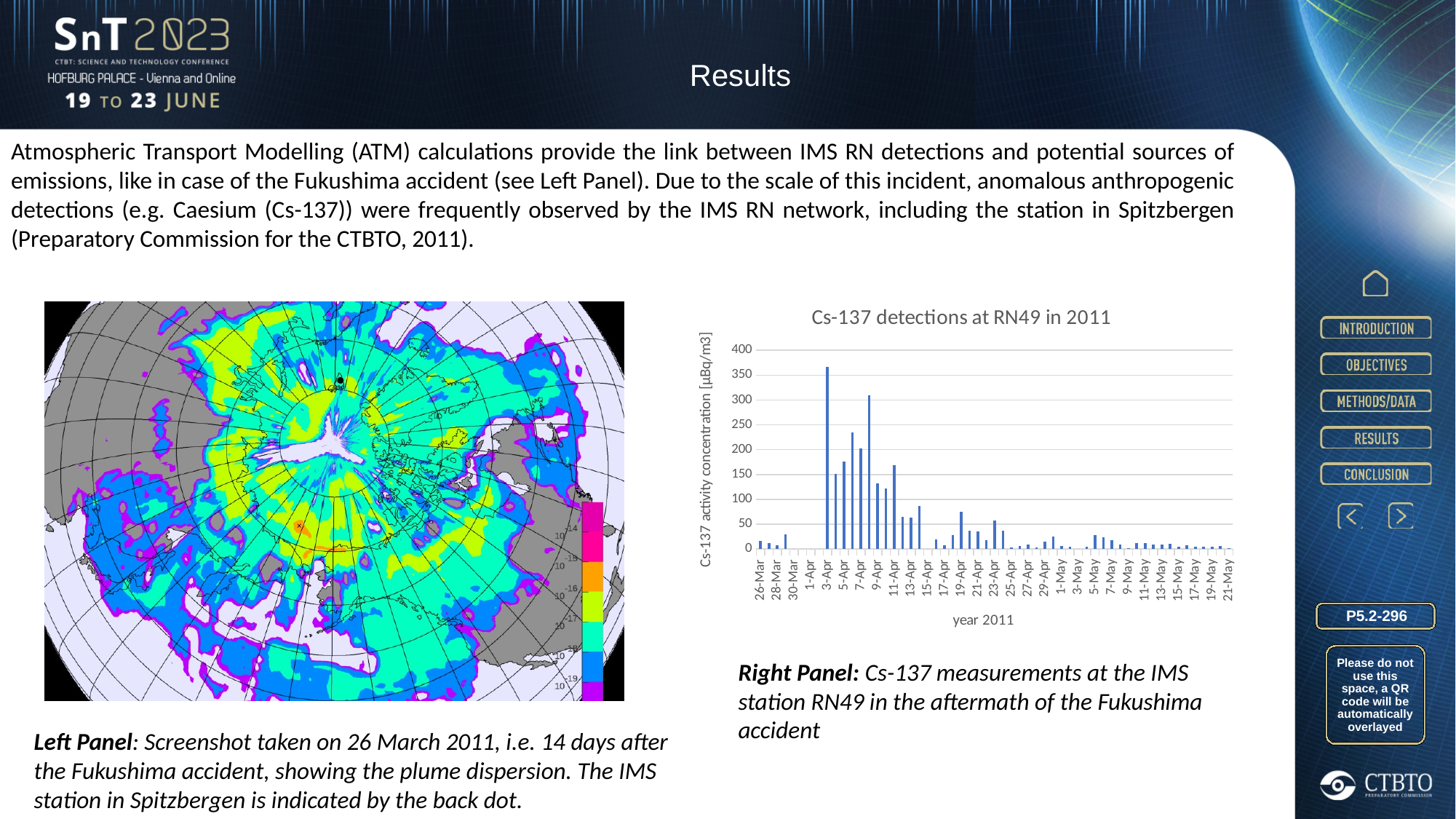
In the chart 'Cs-137 detections at RN49 in 2011', do the values generally rise or fall from early April to late May? fall In the chart 'Cs-137 detections at RN49 in 2011', which date has the larger value, 26-Mar or 3-Apr? 3-Apr In the chart 'Cs-137 detections at RN49 in 2011', which date has the larger value, 3-Apr or 21-May? 3-Apr What is the highest value shown on the y-axis of the chart 'Cs-137 detections at RN49 in 2011'? 400 What is the title of the chart on the right panel? Cs-137 detections at RN49 in 2011 In the chart 'Cs-137 detections at RN49 in 2011', is the value for 3-Apr greater or less than 300? greater What is the y-axis label of the chart 'Cs-137 detections at RN49 in 2011'? Cs-137 activity concentration [μBq/m3] In the chart 'Cs-137 detections at RN49 in 2011', is the value for 26-Mar greater or less than 50? less In the chart 'Cs-137 detections at RN49 in 2011', on which date does the highest bar occur? 3-Apr What kind of chart is 'Cs-137 detections at RN49 in 2011'? bar chart In the chart 'Cs-137 detections at RN49 in 2011', is the value for 21-May greater or less than 50? less